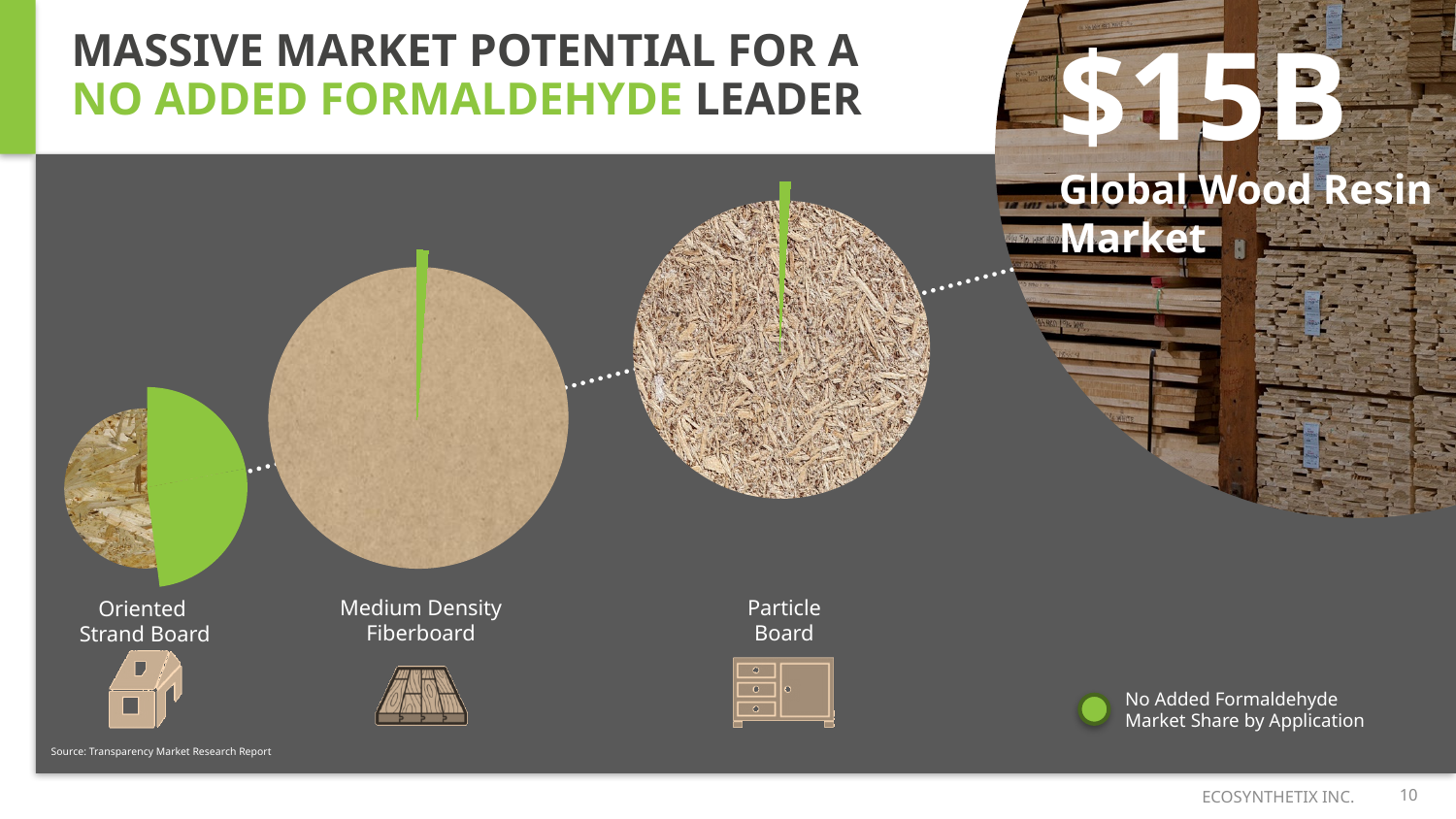
How many pie charts are shown on the slide? 3 Which three applications are labelled under the pie charts? Oriented Strand Board, Medium Density Fiberboard, Particle Board Is the green share in the Particle Board pie greater or less than 25%? less What does the green colour in the pie charts represent, according to the legend? No Added Formaldehyde Market Share by Application What is the size of the Global Wood Resin Market stated on the slide? $15B What kind of chart is used to show the No Added Formaldehyde market share for each application? Pie chart Is the green No Added Formaldehyde share larger in the Oriented Strand Board pie or the Particle Board pie? Oriented Strand Board Is the green share in the Medium Density Fiberboard pie greater or less than 25%? less Is the green No Added Formaldehyde share larger in the Oriented Strand Board pie or the Medium Density Fiberboard pie? Oriented Strand Board Which application's pie chart shows the largest green (No Added Formaldehyde) share? Oriented Strand Board Is the green share in the Oriented Strand Board pie greater or less than 25%? greater